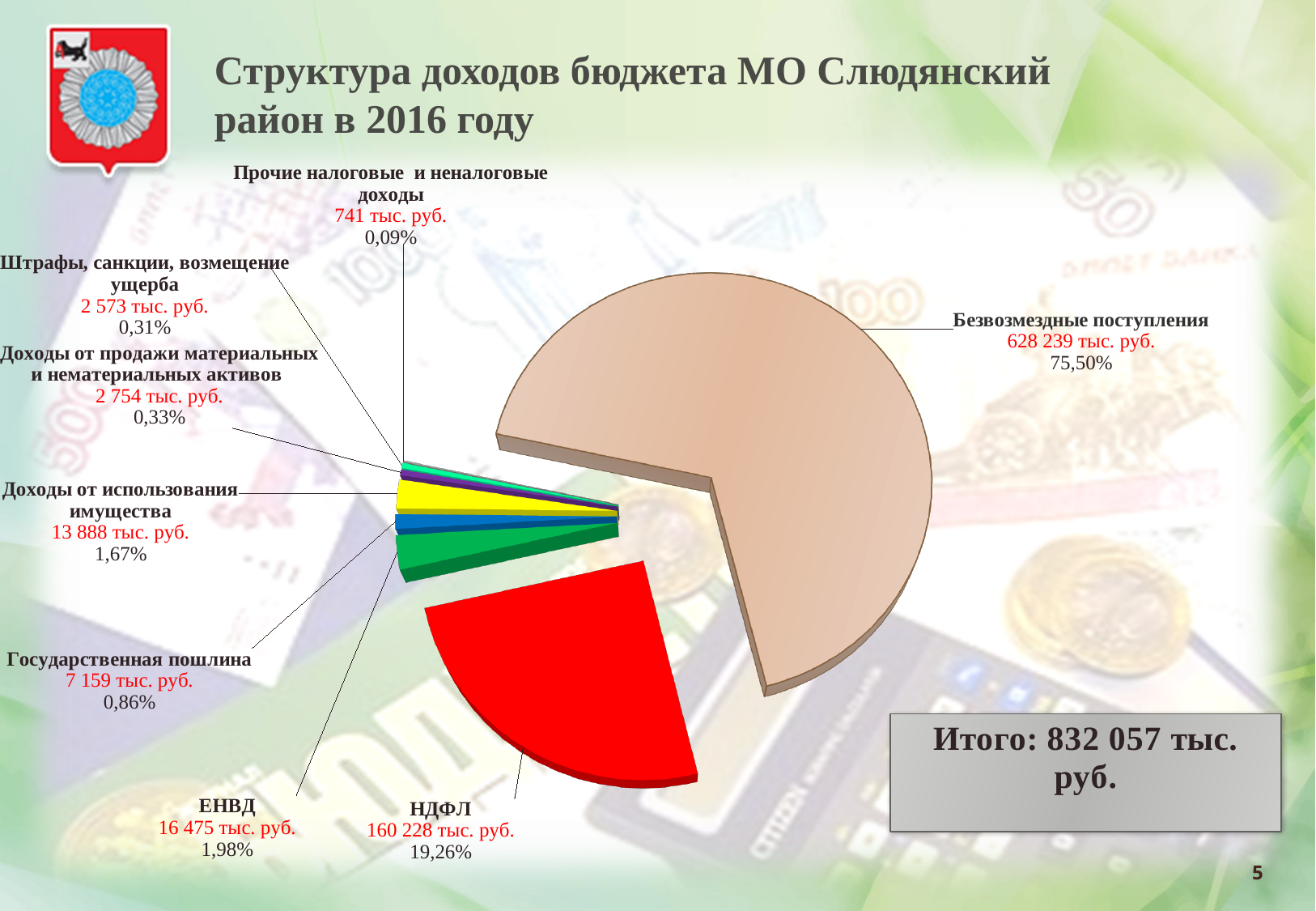
What is the value for ЕНВД? 16 475 тыс. руб. What kind of chart is shown on the slide? Pie chart Which category has the largest slice of the pie? Безвозмездные поступления What share of the pie does Безвозмездные поступления represent? 75,50% What is the value for Безвозмездные поступления? 628 239 тыс. руб. What is the difference between the values for ЕНВД and Государственная пошлина? 9 316 тыс. руб. What is the total of all budget revenues shown on the slide? 832 057 тыс. руб. What is the title of the slide? Структура доходов бюджета МО Слюдянский район в 2016 году Which is larger: Доходы от использования имущества or Государственная пошлина? Доходы от использования имущества What share of the pie does НДФЛ represent? 19,26% How many categories are shown in the pie chart? 8 Which category has the smallest slice of the pie? Прочие налоговые и неналоговые доходы